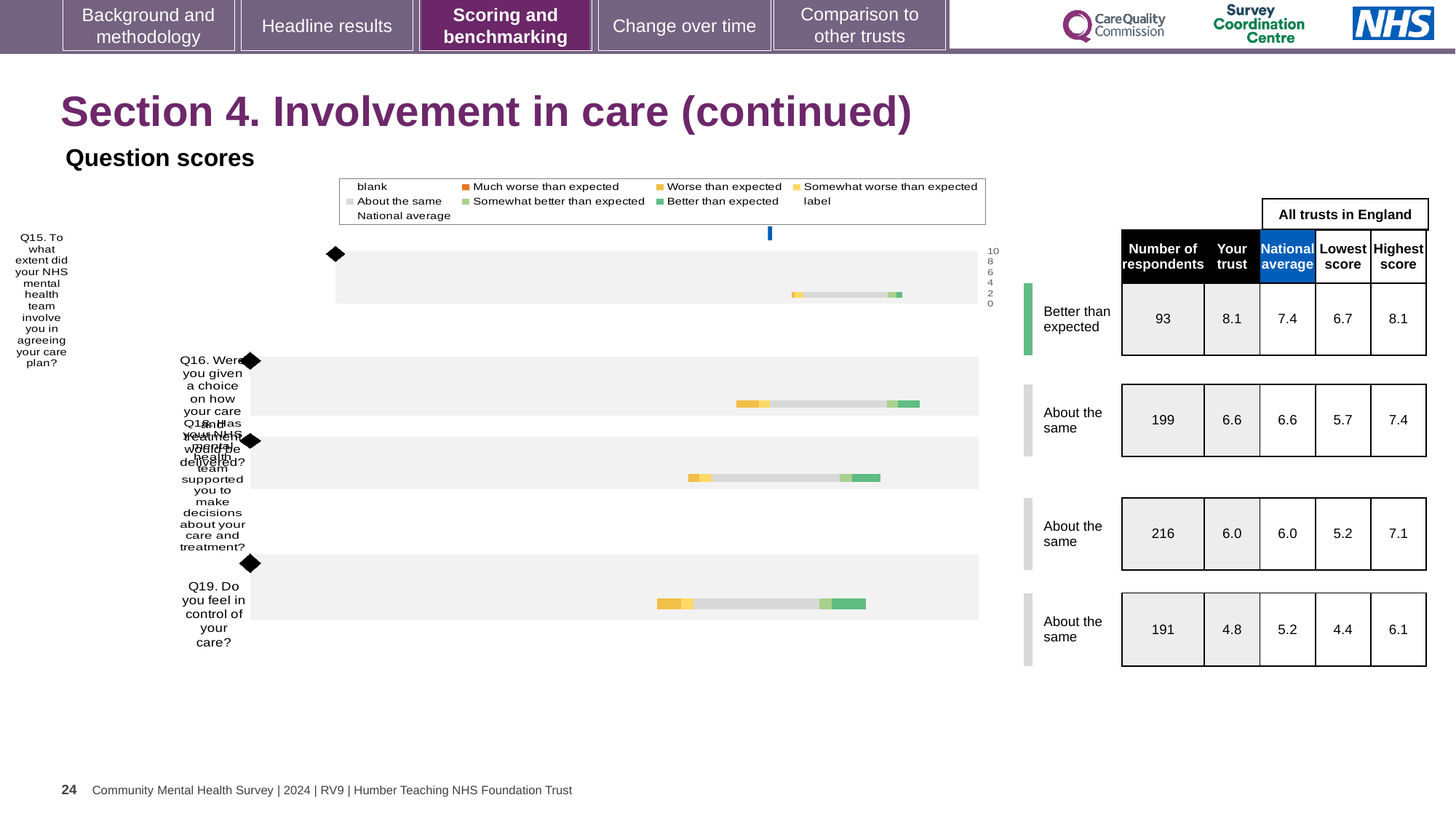
For Q19, which is larger: the 'Your trust' score or the national average? National average How many respondents are listed for Q15 in the table beside the chart? 93 Which question has the lowest 'Your trust' score? Q19 For Q15, what is the difference between the 'Your trust' score and the national average? 0.7 What is the national average score for Q16? 6.6 What is the 'Your trust' score for Q19 (Do you feel in control of your care?)? 4.8 What kind of chart is used to show the question scores on this slide? bar chart What benchmark category is shown for Q15 next to the chart? Better than expected What is the 'Your trust' score for Q15 (involving you in agreeing your care plan)? 8.1 What is the lowest score across all trusts in England for Q18? 5.2 Which question has the highest 'Your trust' score? Q15 How many questions are plotted in the question scores chart? 4